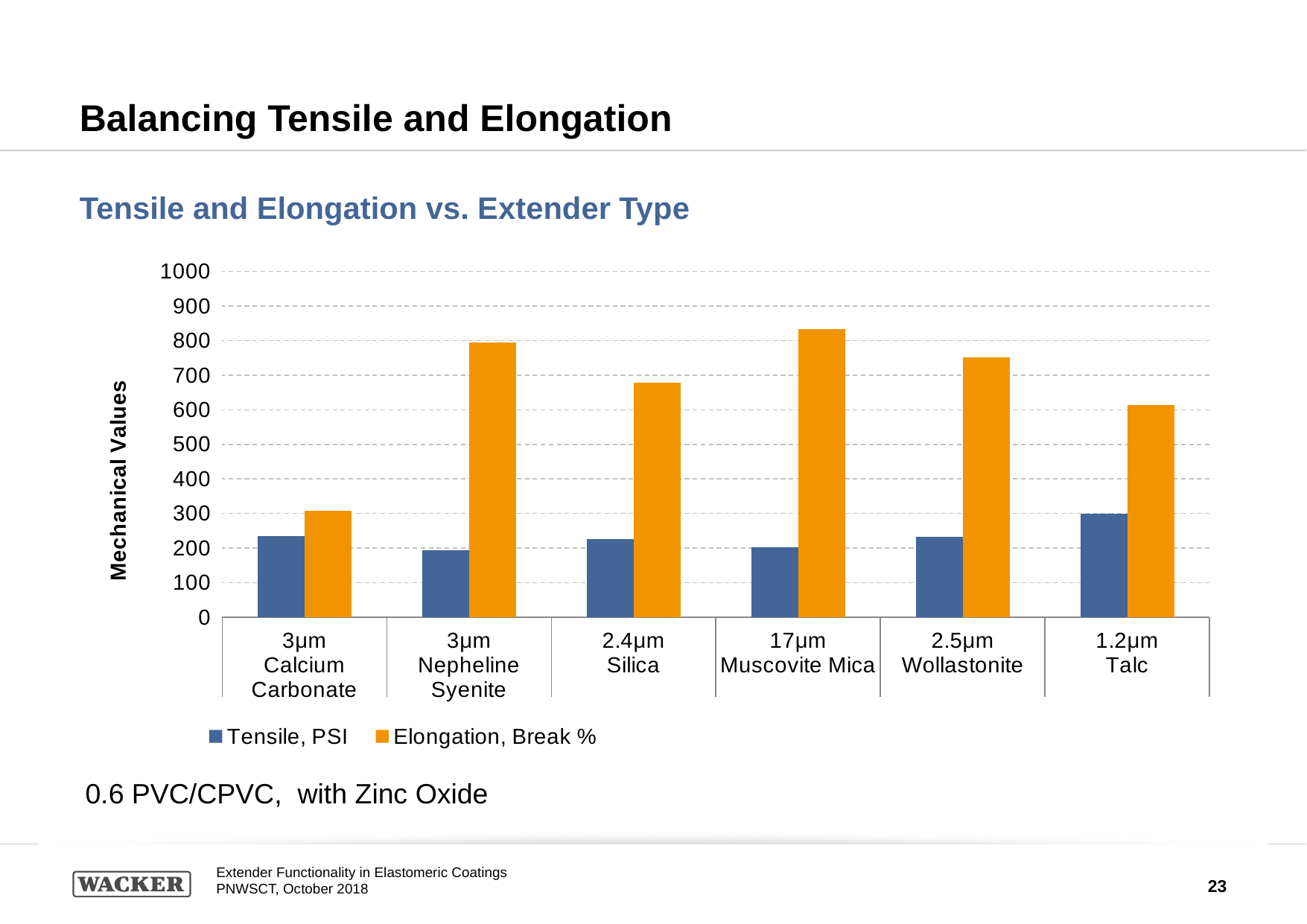
Is the Elongation, Break % value for 17µm Muscovite Mica greater or less than 800? greater What kind of chart is shown on the slide? bar chart Which has the larger Elongation, Break % value: 3µm Nepheline Syenite or 2.4µm Silica? 3µm Nepheline Syenite Is the Elongation, Break % value for 1.2µm Talc greater or less than 700? less Which extender type has the lowest Elongation, Break %? 3µm Calcium Carbonate How many series does the legend list? 2 Is the Elongation, Break % value for 3µm Nepheline Syenite greater or less than 700? greater Which extender type has the highest Tensile, PSI? 1.2µm Talc How many extender types are shown on the x axis? 6 Which extender type has the highest Elongation, Break %? 17µm Muscovite Mica What is the label on the vertical axis of the chart? Mechanical Values